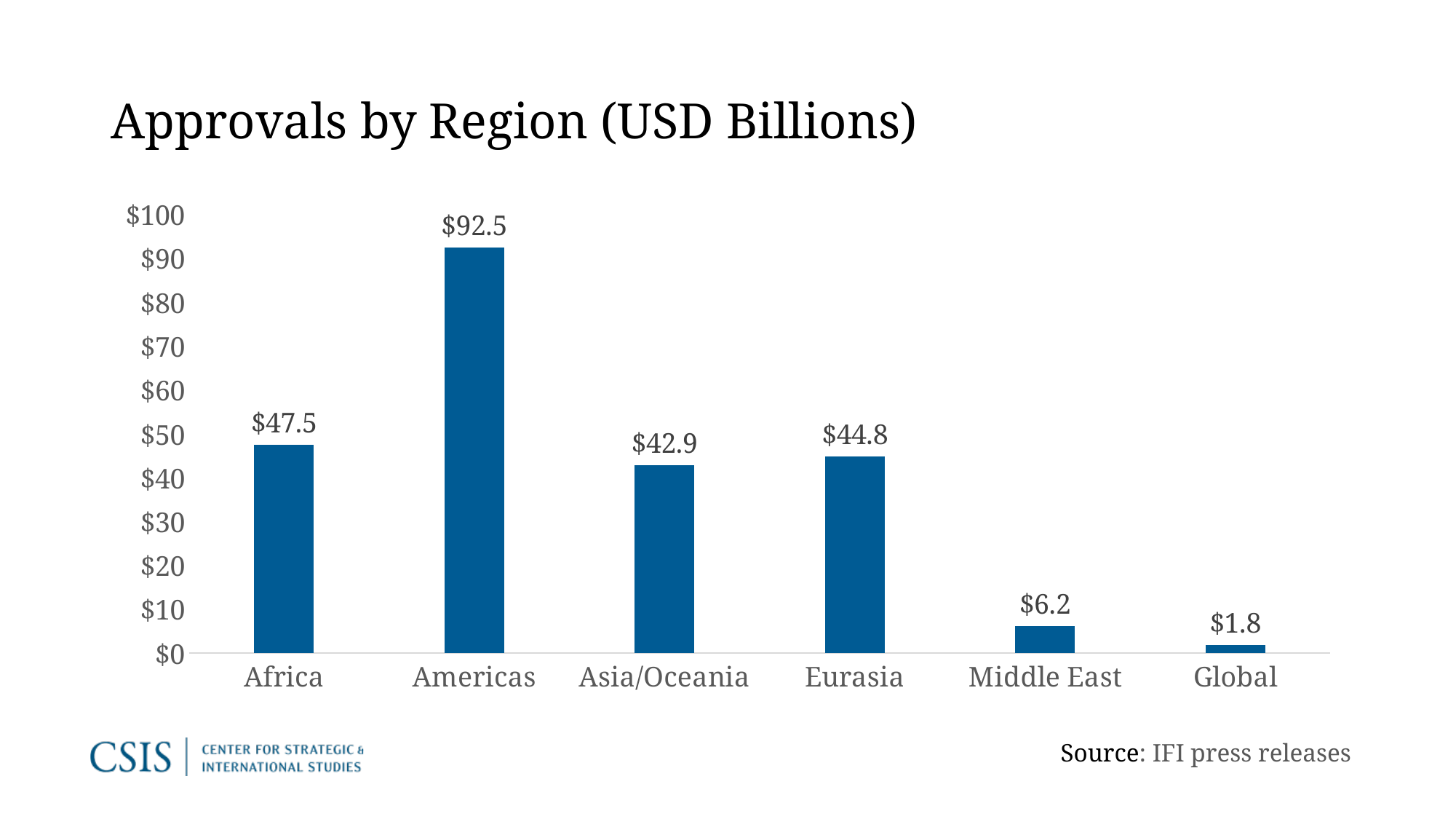
What is the source cited for the chart? IFI press releases What is the title of the chart? Approvals by Region (USD Billions) What is the value for Middle East? $6.2 Which is larger, the value for Africa or the value for Eurasia? Africa Is the value for Eurasia greater or less than $40? greater What is the value for Americas? $92.5 What is the difference between the values for Americas and Africa? $45.0 How many regions are shown on the chart? 6 Which region has the highest approvals? Americas Which category has the lowest value? Global What is the value for Asia/Oceania? $42.9 What kind of chart is shown on the slide? Bar chart